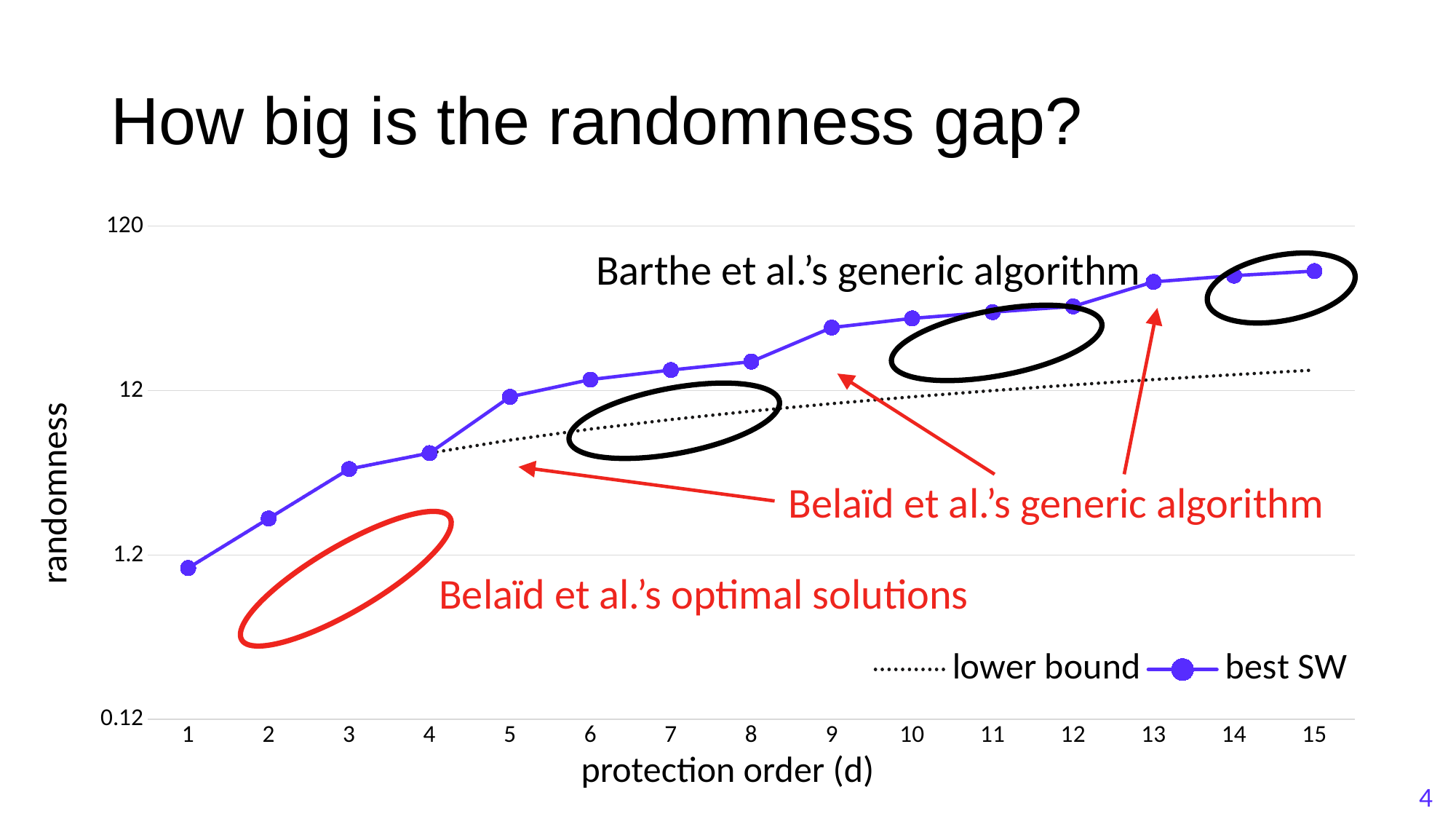
At protection order 10, which is larger: the best SW value or the lower bound? best SW Is the best SW value at protection order 9 greater or less than 12? greater How many protection order values are plotted along the x axis? 15 What kind of chart is shown on the slide? line chart Is the best SW value at protection order 4 greater or less than 12? less At which protection order is the best SW value highest? 15 What is the label of the y axis? randomness What is the label of the x axis? protection order (d) At which protection order is the best SW value lowest? 1 Is the best SW value at protection order 15 greater or less than 120? less Does the best SW series rise or fall as the protection order increases? rises How many series does the legend list? 2